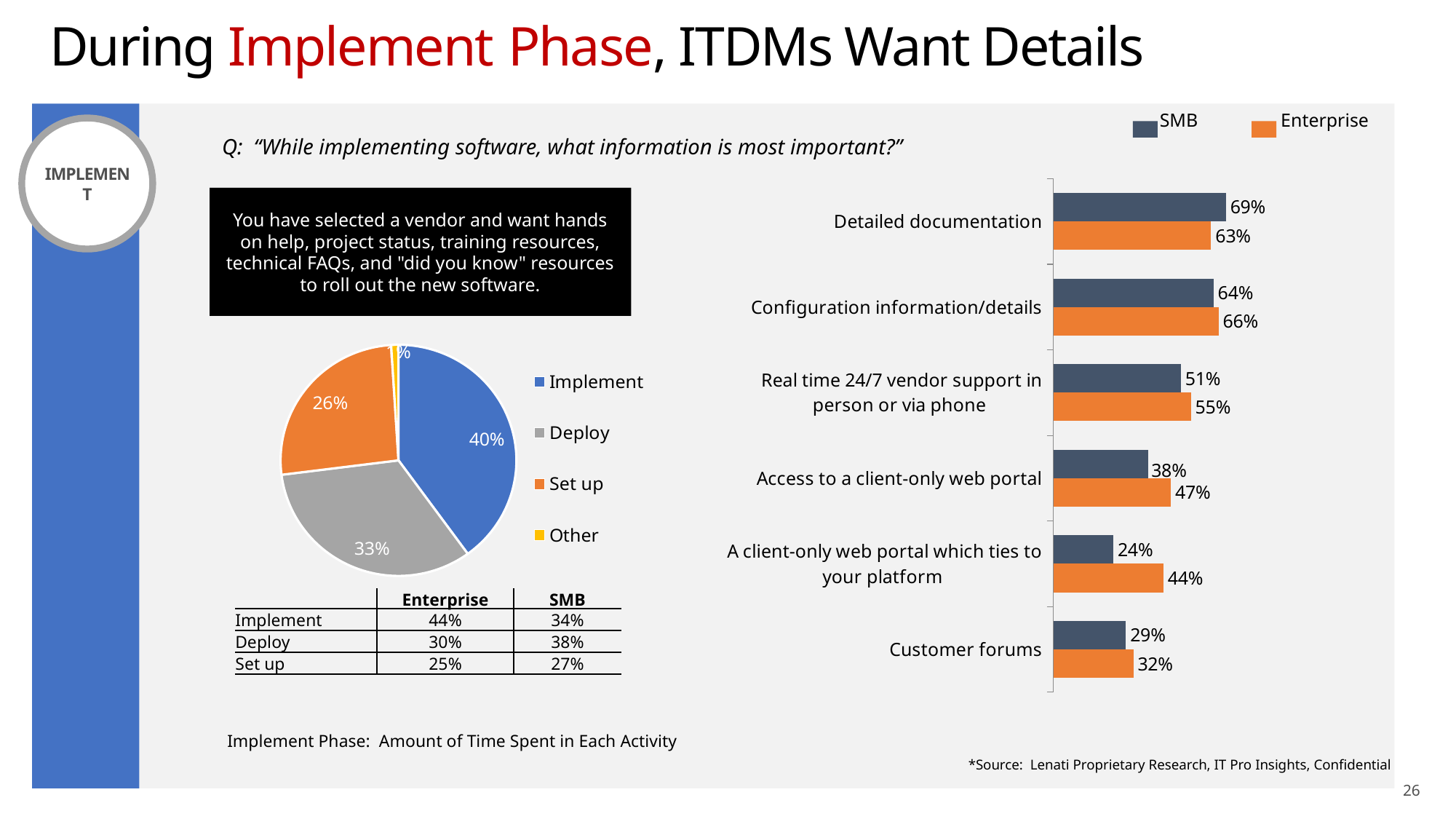
In the pie chart titled 'Implement Phase: Amount of Time Spent in Each Activity', which activity has the largest slice? Implement In the pie chart titled 'Implement Phase: Amount of Time Spent in Each Activity', what share does Implement have? 40% In the bar chart on the right, which category has the lowest SMB value? A client-only web portal which ties to your platform In the bar chart on the right, what is the SMB value for Detailed documentation? 69% What kind of chart is the chart on the right of the slide? Bar chart In the bar chart on the right, which category has the highest Enterprise value? Configuration information/details How many slices does the pie chart titled 'Implement Phase: Amount of Time Spent in Each Activity' have? 4 How many categories are shown in the bar chart on the right? 6 In the bar chart on the right, what is the difference between the Enterprise and SMB values for A client-only web portal which ties to your platform? 20 percentage points How many series does the legend of the bar chart on the right list? 2 In the bar chart on the right, what is the Enterprise value for Access to a client-only web portal? 47% In the bar chart on the right, for Detailed documentation, which is larger: the SMB value or the Enterprise value? SMB